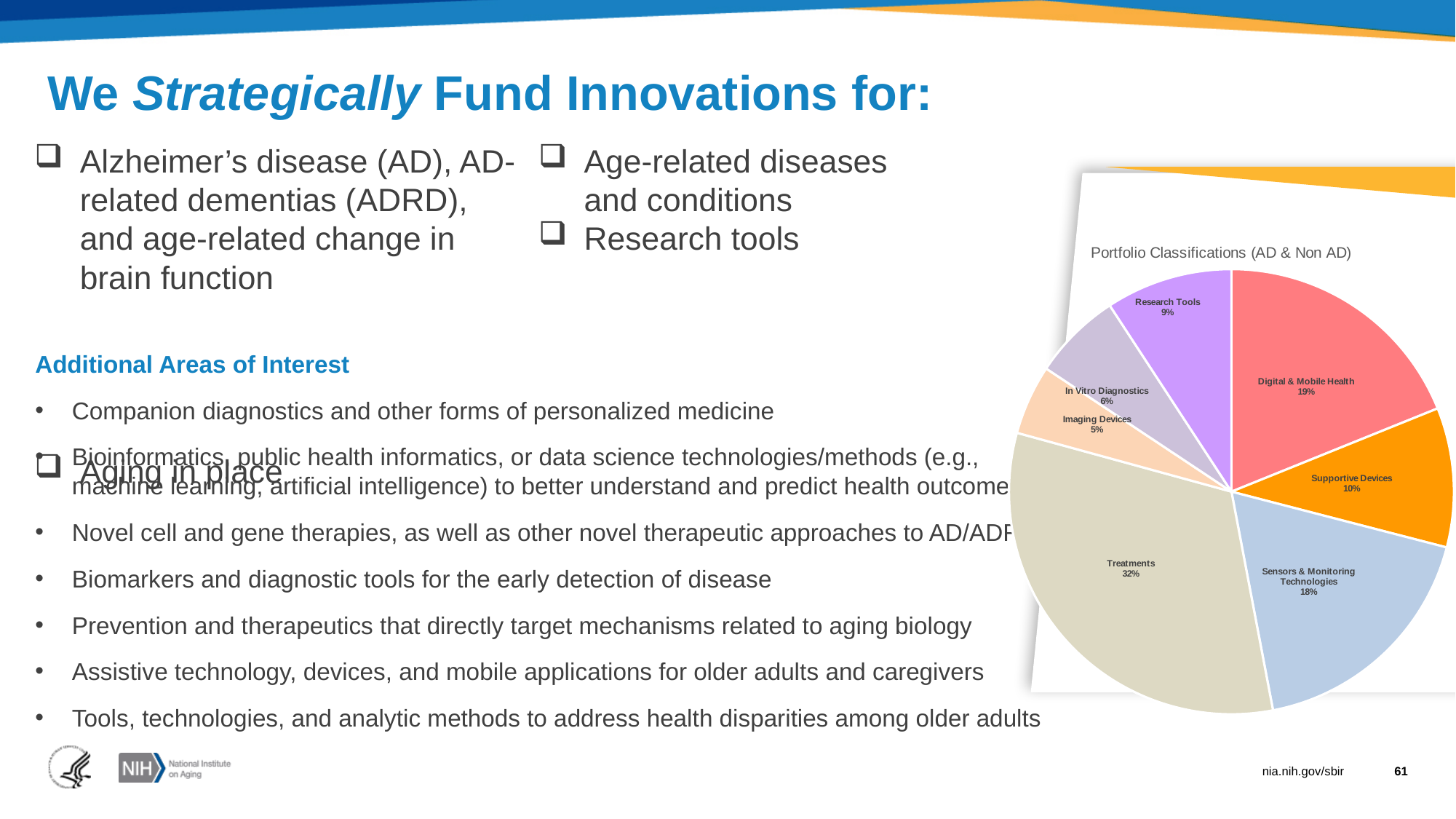
Which is larger, In Vitro Diagnostics or Research Tools? Research Tools What is the difference in percentage points between Treatments and Supportive Devices? 22 Which category has the largest slice of the pie? Treatments What percentage is shown for Research Tools? 9% What percentage is shown for Digital & Mobile Health? 19% What share of the pie does Treatments represent? 32% What kind of chart is shown on the slide? Pie chart What percentage is shown for Sensors & Monitoring Technologies? 18% Which category has the smallest slice of the pie? Imaging Devices How many slices does the pie chart have? 7 What is the title of the pie chart? Portfolio Classifications (AD & Non AD) What percentage is shown for Imaging Devices? 5%